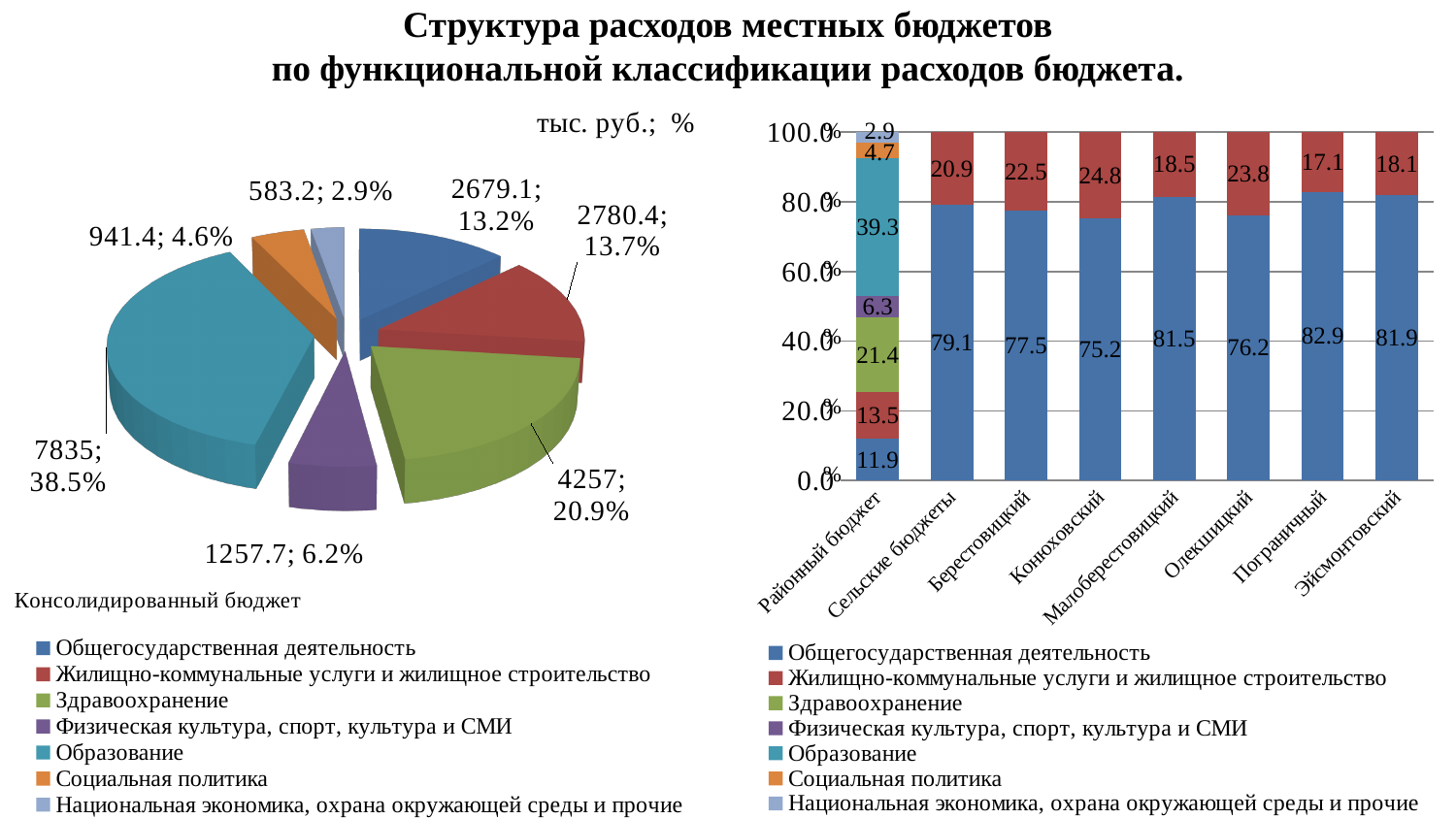
In the bar chart on the right, what is the difference between the Общегосударственная деятельность values for Пограничный and Конюховский? 7.7 In the bar chart on the right, how many categories are shown on the x axis? 8 In the bar chart on the right, what is the value of Общегосударственная деятельность for Пограничный? 82.9 In the pie chart on the left, what value is shown for Здравоохранение? 4257; 20.9% What kind of chart is on the right side of the slide? Stacked bar chart In the bar chart on the right, which is larger: Общегосударственная деятельность for Сельские бюджеты or for Олекшицкий? Сельские бюджеты In the pie chart on the left, which category has the largest slice? Образование In the pie chart on the left, what share does Образование have? 38.5% In the bar chart on the right, what is the value of Образование for Районный бюджет? 39.3 How many series does the legend of the pie chart on the left list? 7 In the bar chart on the right, what is the value of Жилищно-коммунальные услуги и жилищное строительство for Конюховский? 24.8 In the pie chart on the left, which category has the smallest slice? Национальная экономика, охрана окружающей среды и прочие